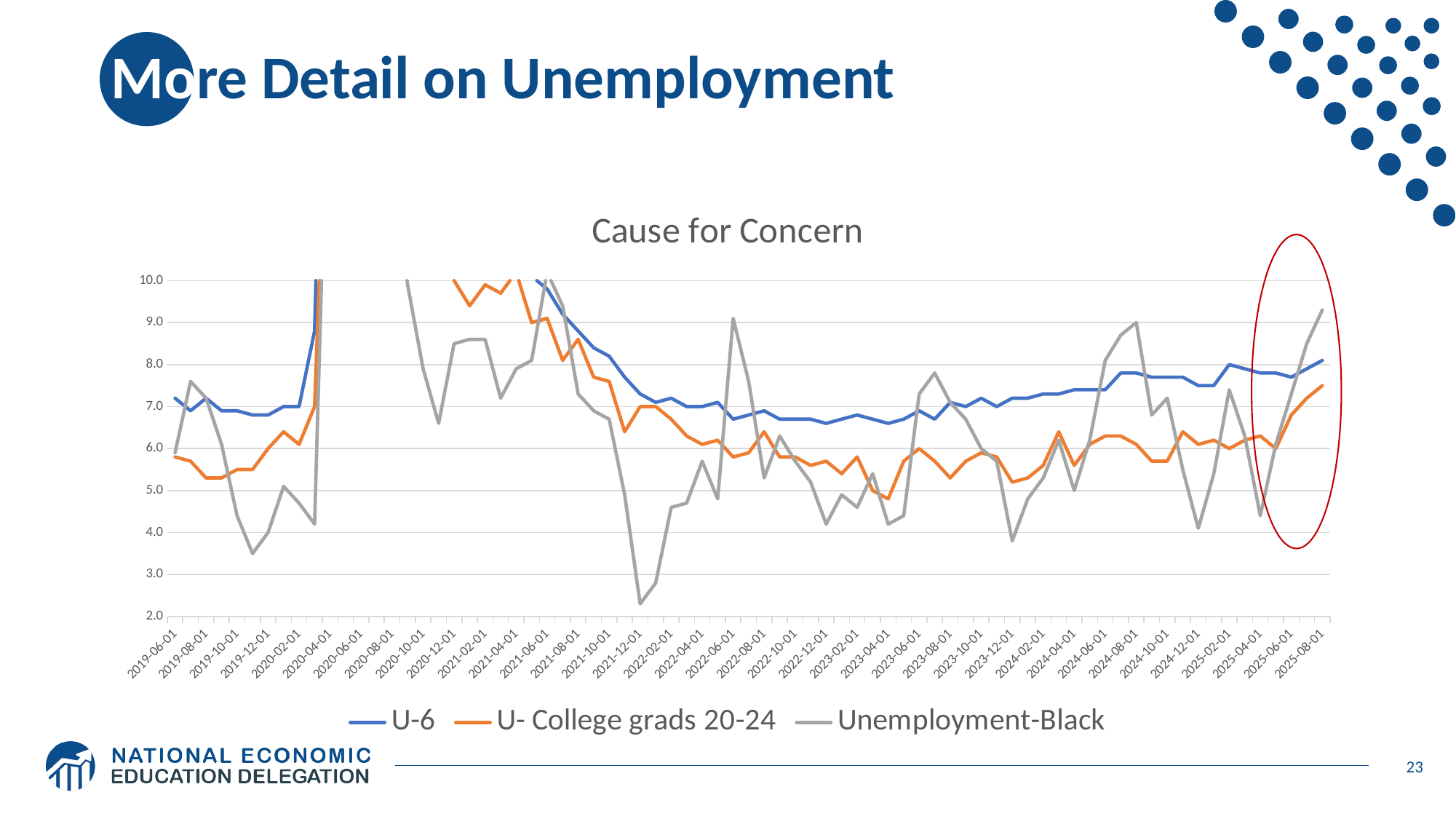
Is the value for Unemployment-Black at 2021-12-01 greater or less than 3.0? less What kind of chart is shown on the slide? Line chart What is the title of the chart? Cause for Concern Is the value for Unemployment-Black at 2025-08-01 greater or less than 9.0? greater Which series reaches the lowest value anywhere on the chart? Unemployment-Black How many series does the legend of the chart list? 3 Is the value for U- College grads 20-24 at 2025-08-01 greater or less than 7.0? greater Does the U-6 series rise or fall between 2021-06-01 and 2022-10-01? Fall At 2019-06-01, which is higher: U-6 or U- College grads 20-24? U-6 At 2025-08-01, which is higher: U-6 or Unemployment-Black? Unemployment-Black Which series in the chart is drawn in orange? U- College grads 20-24